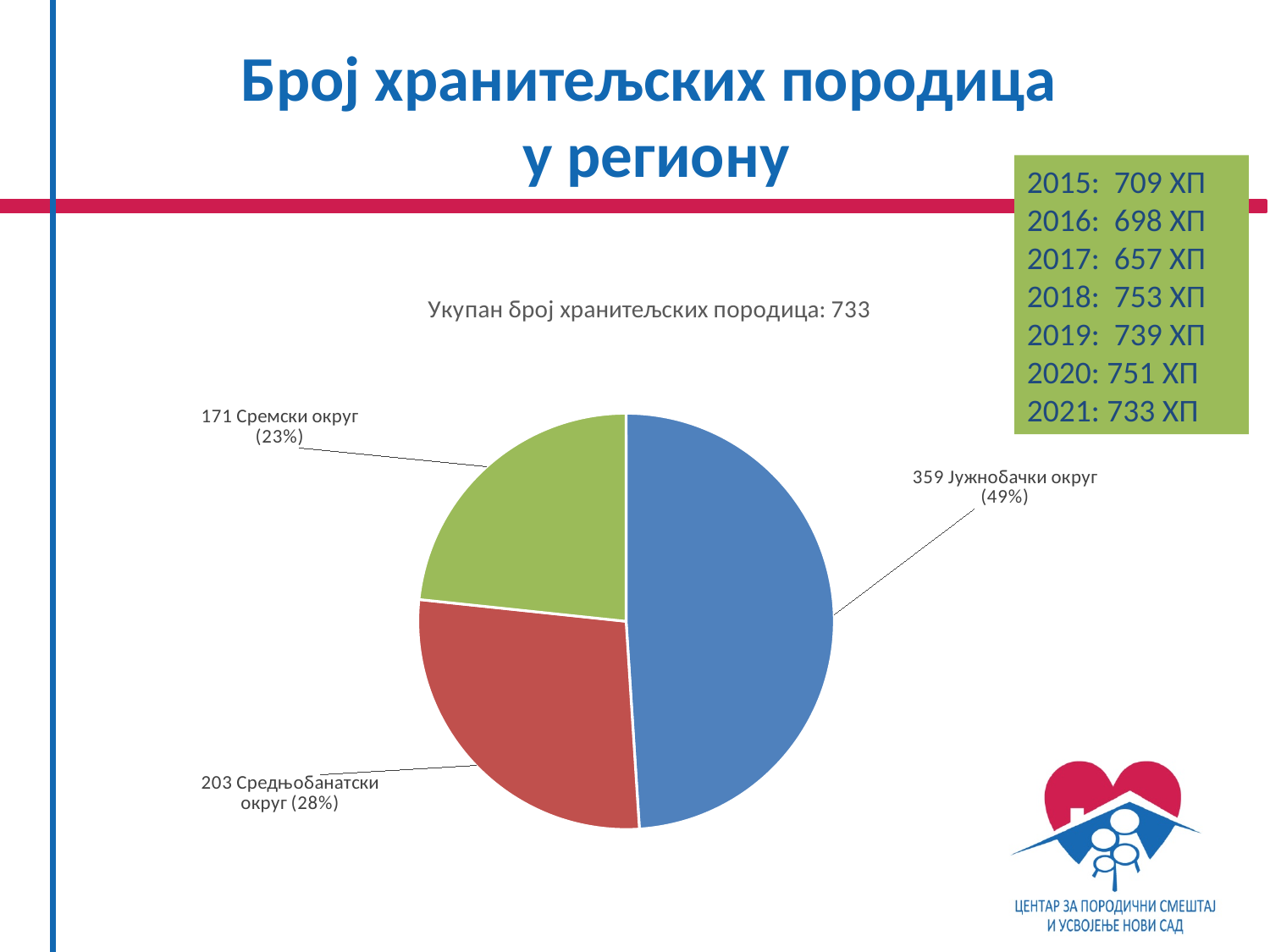
What type of chart is shown on the slide? pie chart How many slices does the pie chart have? 3 What is the chart's title? Укупан број хранитељских породица: 733 What is the difference between the values for Јужнобачки округ and Средњобанатски округ? 156 What share of the pie does Јужнобачки округ represent? 49% Which district has the largest slice of the pie? Јужнобачки округ What is the value for Јужнобачки округ? 359 What share of the pie does Сремски округ represent? 23% What is the value for Сремски округ? 171 What is the value for Средњобанатски округ? 203 Which is larger, the value for Средњобанатски округ or Сремски округ? Средњобанатски округ Which district has the smallest slice of the pie? Сремски округ